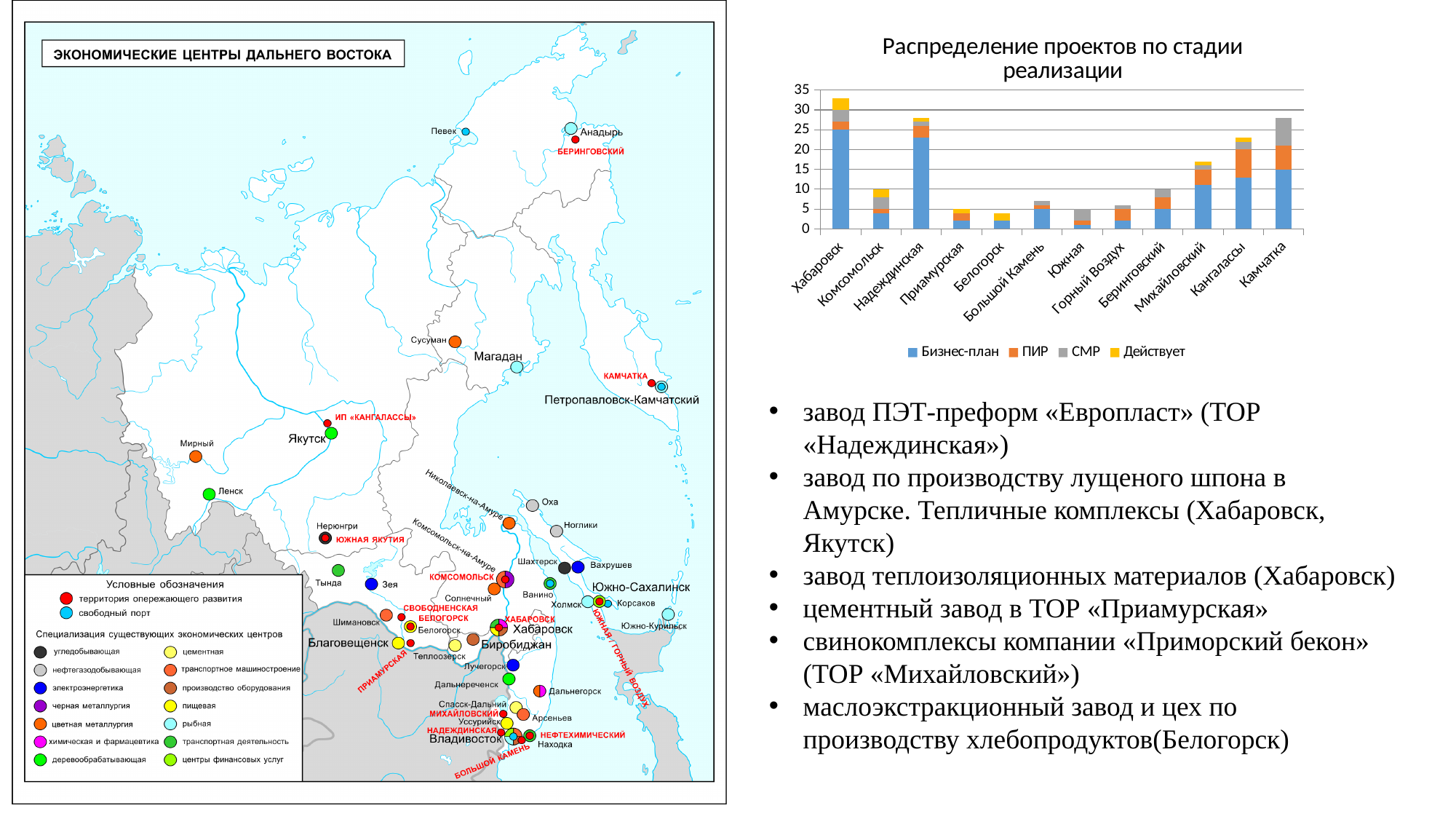
Is the Бизнес-план value for Кангалассы greater or less than 10? greater Which category has the tallest stacked bar in the chart? Хабаровск How many categories are shown on the x axis of the chart? 12 What is the title of the chart? Распределение проектов по стадии реализации Which colour represents the Бизнес-план series in the chart? blue Is the total stacked bar for Белогорск greater or less than 5? less What kind of chart is shown on the slide? bar chart Is the total stacked bar for Хабаровск greater or less than 30? greater How many series does the chart legend list? 4 Which has the larger Бизнес-план value, Камчатка or Михайловский? Камчатка Which has the taller stacked bar, Кангалассы or Михайловский? Кангалассы